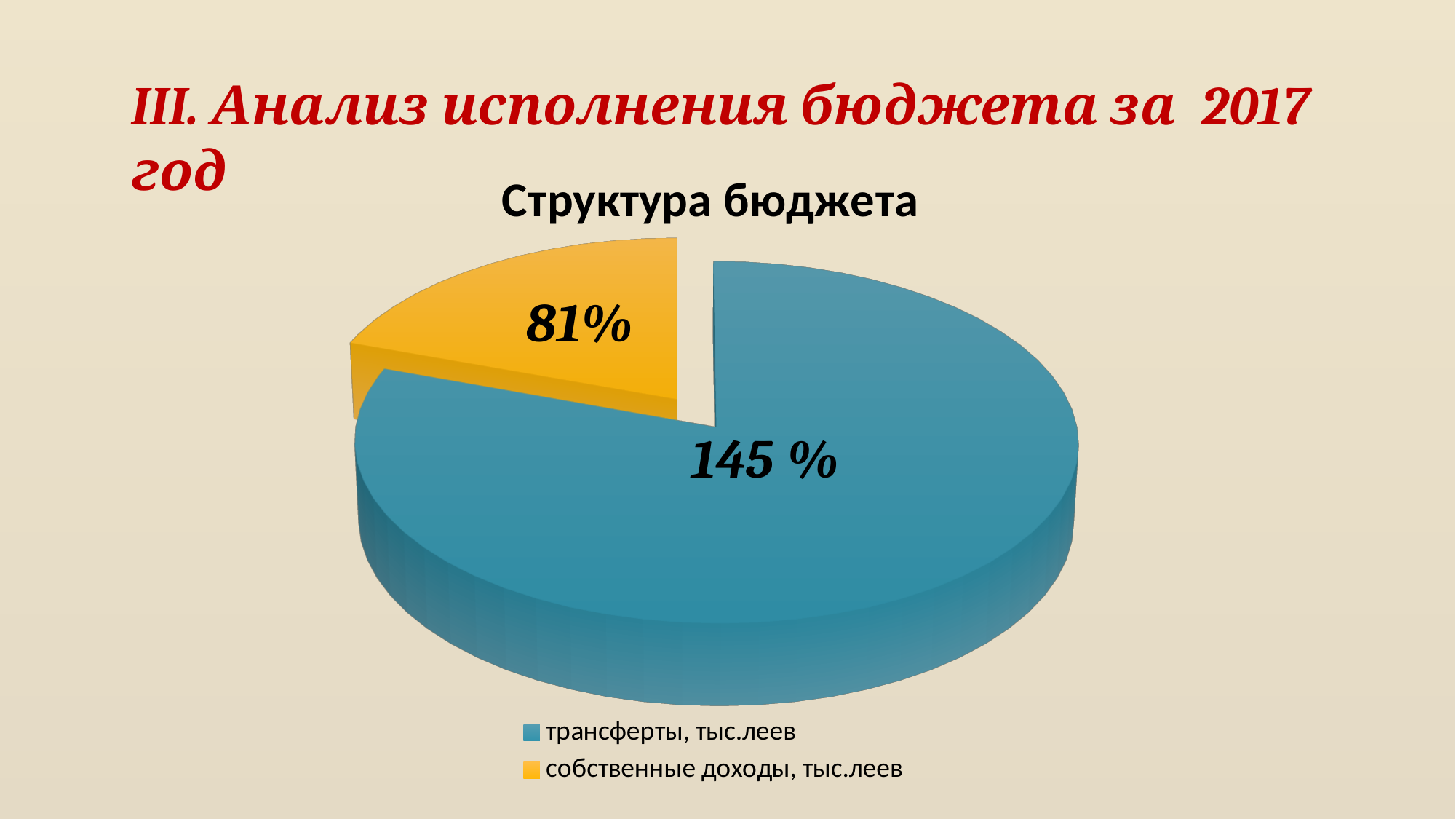
What kind of chart is shown on the slide? pie chart What colour is the slice for собственные доходы, тыс.леев? yellow What value is printed on the slice for собственные доходы, тыс.леев? 81% What is the title of the chart? Структура бюджета How many entries does the legend list? 2 Which is larger: the value for трансферты, тыс.леев or the value for собственные доходы, тыс.леев? трансферты, тыс.леев Which slice is the smallest in the pie chart? собственные доходы, тыс.леев Which slice is the largest in the pie chart? трансферты, тыс.леев What is the difference between the printed values for трансферты, тыс.леев and собственные доходы, тыс.леев? 64% How many slices does the pie chart have? 2 What value is printed on the slice for трансферты, тыс.леев? 145 %